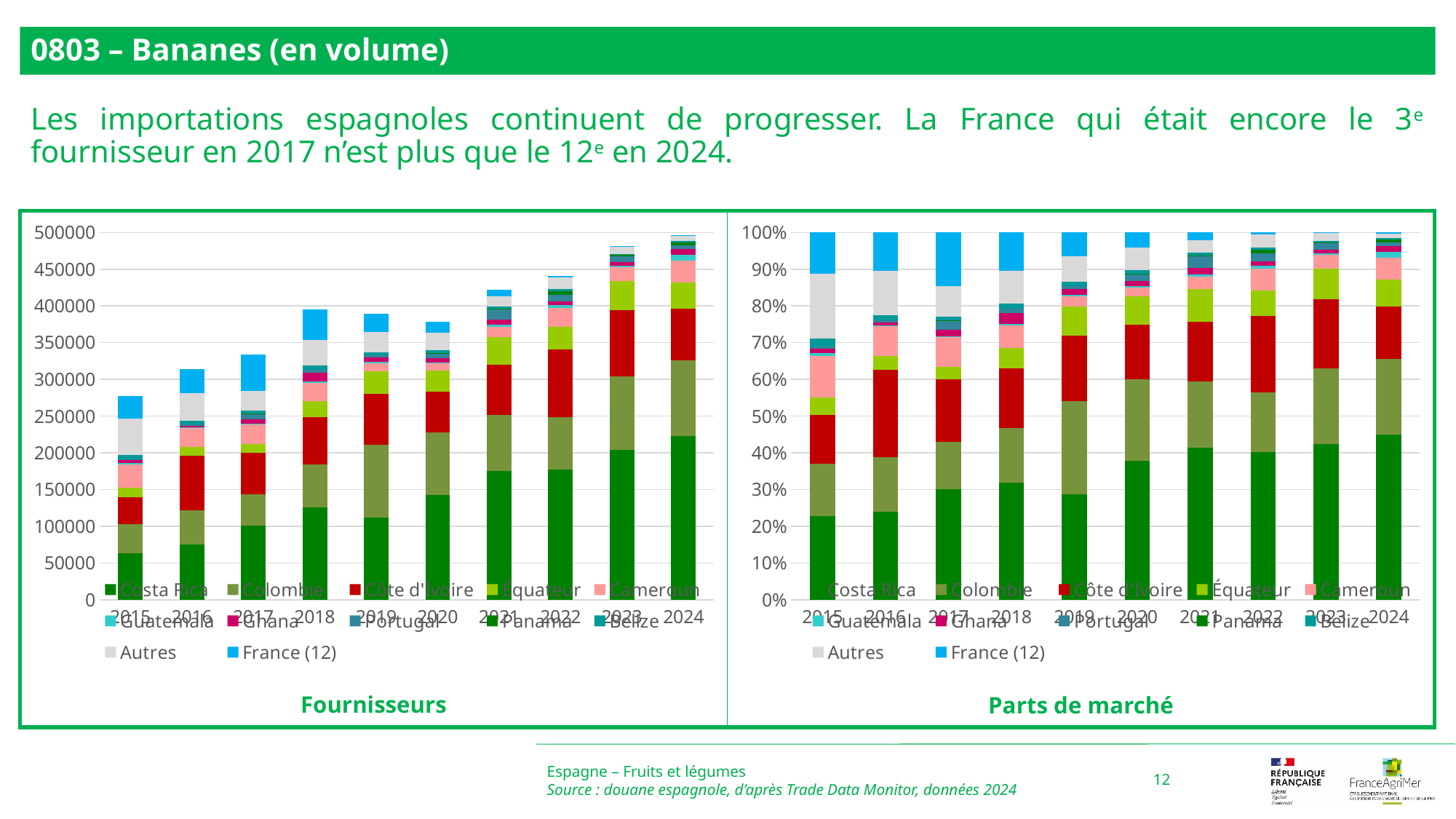
In the 'Fournisseurs' chart, which year has the highest total bar? 2024 What kind of chart is the 'Fournisseurs' chart? stacked bar chart In the 'Fournisseurs' chart, is the total bar for 2021 greater or less than 400000? greater In the 'Fournisseurs' chart, do the total bars generally rise or fall from 2015 to 2024? rise In the 'Parts de marché' chart, is the Costa Rica share in 2024 greater or less than 40%? greater In the 'Fournisseurs' chart, which year has the lowest total bar? 2015 In the 'Fournisseurs' chart, which total bar is larger, 2017 or 2018? 2018 In the 'Fournisseurs' chart, is the total bar for 2023 greater or less than 450000? greater How many years are shown on the x axis of the 'Fournisseurs' chart? 10 Which series is listed last in the legend of the 'Fournisseurs' chart? France (12) How many series does the legend of the 'Parts de marché' chart list? 12